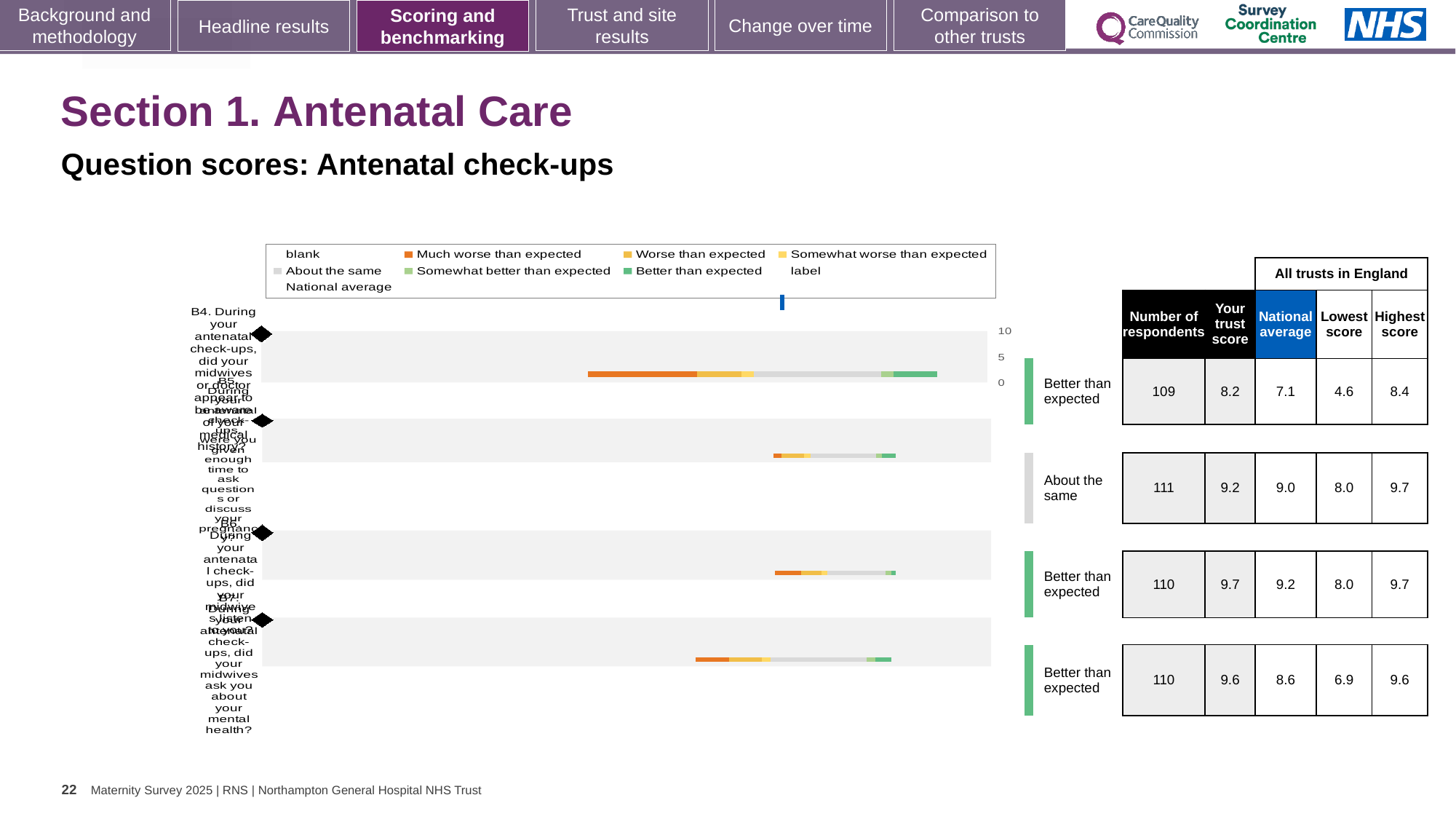
How many entries does the chart legend list? 9 In the table, what is the lowest score among all trusts in England for the first row? 4.6 Which row of the table has the lowest 'Your trust score'? the first row (8.2) Which row of the table has the highest 'Your trust score'? the third row (9.7) In the second row, which is larger: the trust score or the national average? the trust score (9.2) What benchmark category is shown next to the second row? About the same How many question rows (bars) does the chart show? 4 What kind of chart is shown on the slide? bar chart In the table, what is the national average for the fourth (bottom) row? 8.6 In the fourth (bottom) row, what is the difference between the trust score and the national average? 1.0 In the table, what is the number of respondents for the second row? 111 In the table, what is the 'Your trust score' for the first (top) row? 8.2